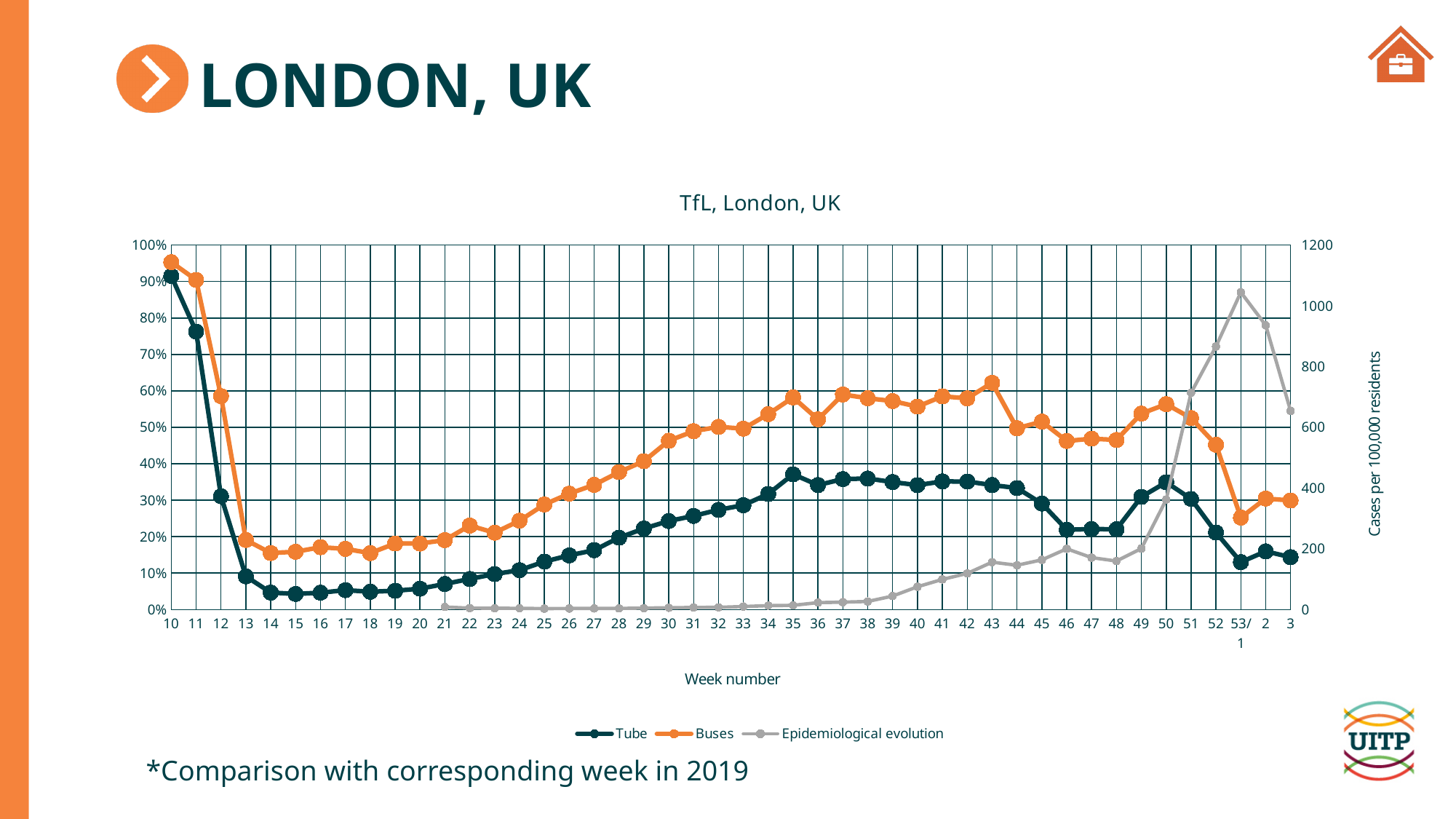
At which week does the Buses series reach its highest value? 10 What kind of chart is shown on the slide? line chart Is the value for Epidemiological evolution at week 53/1 greater or less than 1000? greater At week 30, which series has the larger value, Tube or Buses? Buses Does the Tube series rise or fall from week 10 to week 14? fall What is the title of the chart? TfL, London, UK Does the Buses series rise or fall from week 18 to week 35? rise Is the value for Buses at week 53/1 greater or less than 30%? less How many series does the legend list? 3 What is the label of the right-hand vertical axis? Cases per 100,000 residents Is the value for Buses at week 10 greater or less than 90%? greater